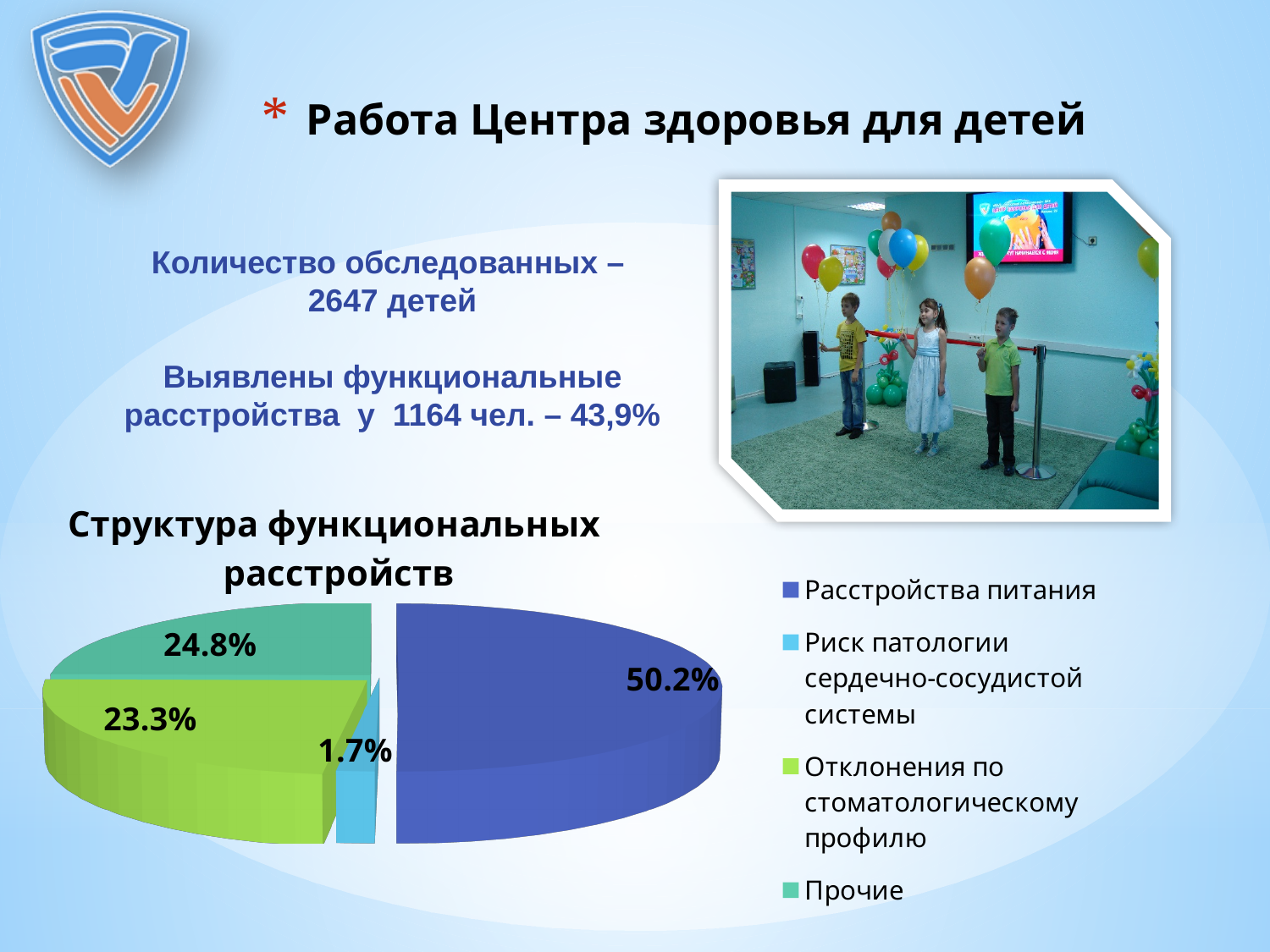
What share of the pie does "Риск патологии сердечно-сосудистой системы" take? 1.7% How many categories does the legend list? 4 What share of the pie does "Отклонения по стоматологическому профилю" take? 23.3% What is the difference between the shares of "Прочие" and "Отклонения по стоматологическому профилю"? 1.5% What share of the pie does "Расстройства питания" take? 50.2% What share of the pie does "Прочие" take? 24.8% Which category has the largest slice of the pie? Расстройства питания What type of chart is shown on the slide? pie chart What is the title of the chart? Структура функциональных расстройств Which category has the smallest slice of the pie? Риск патологии сердечно-сосудистой системы Which is larger: the share of "Прочие" or the share of "Отклонения по стоматологическому профилю"? Прочие What colour is the slice for "Расстройства питания"? blue